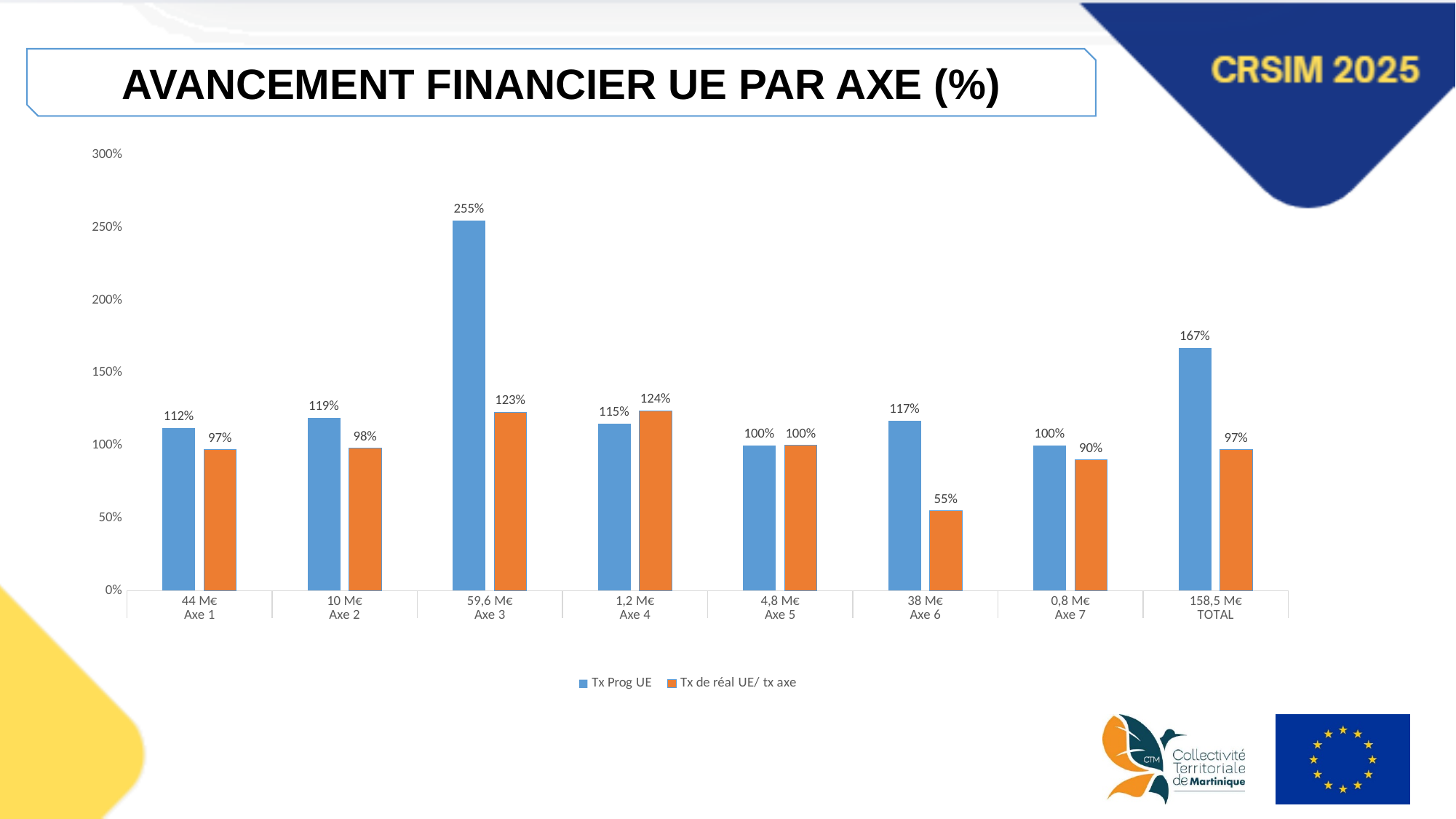
What is the Tx Prog UE value for TOTAL? 167% How many categories are shown on the x axis? 8 Is the Tx Prog UE value for Axe 3 greater or less than 200%? greater What is the Tx de réal UE/ tx axe value for Axe 6? 55% What kind of chart is shown on the slide? Bar chart What is the Tx Prog UE value for Axe 3? 255% What amount in M€ is shown under Axe 3 on the x axis? 59,6 M€ What is the difference between the Tx Prog UE and Tx de réal UE/ tx axe values for Axe 3? 132% How many series does the legend list? 2 For Axe 4, which is larger: Tx Prog UE or Tx de réal UE/ tx axe? Tx de réal UE/ tx axe Which category has the highest Tx Prog UE value? Axe 3 Which category has the lowest Tx de réal UE/ tx axe value? Axe 6